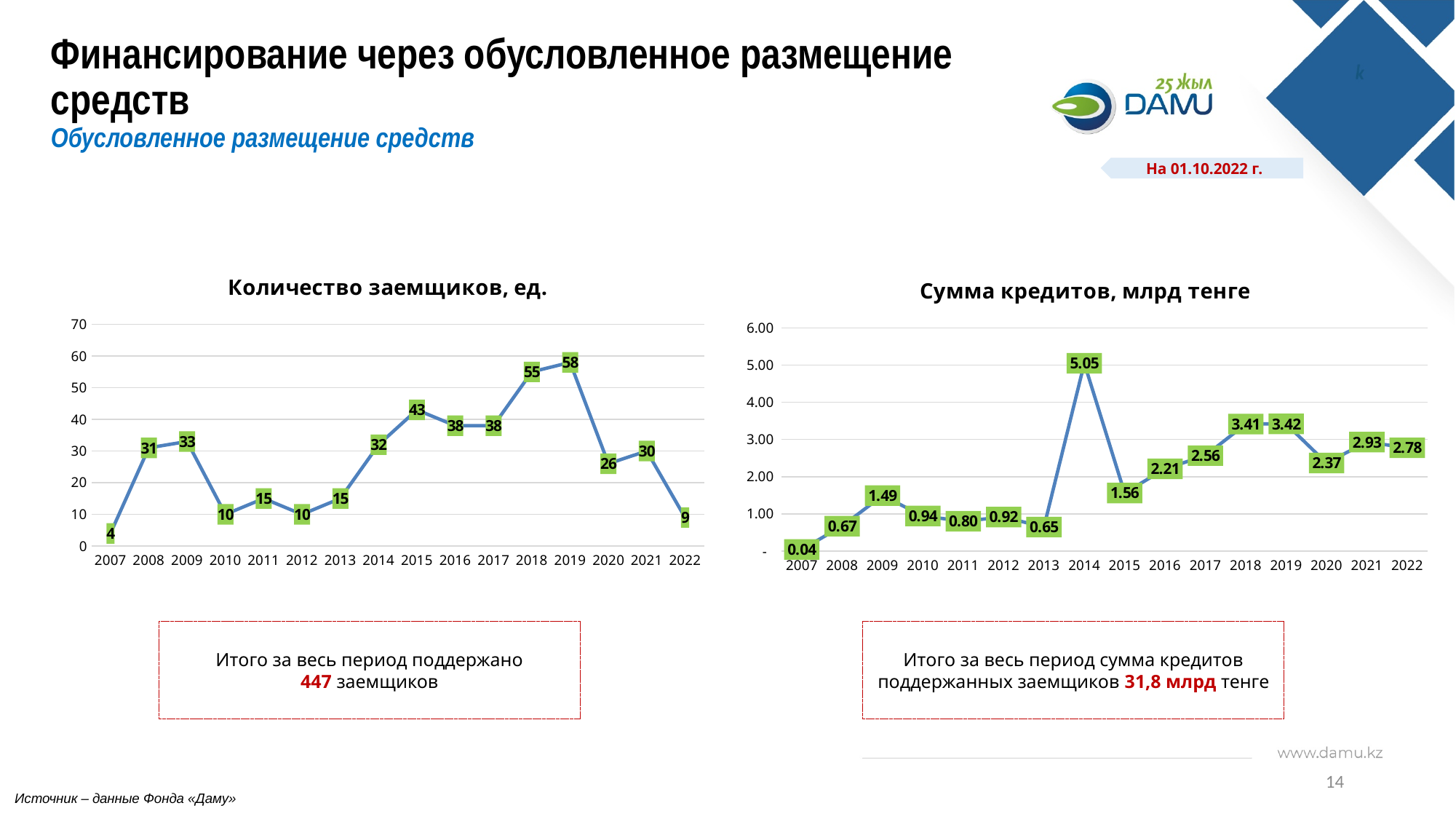
In the chart titled "Количество заемщиков, ед.", which year has the larger value, 2009 or 2014? 2009 How many years are plotted in the chart titled "Количество заемщиков, ед."? 16 In the chart titled "Сумма кредитов, млрд тенге", which year has the highest value? 2014 What type of chart is the chart titled "Сумма кредитов, млрд тенге"? Line chart In the chart titled "Сумма кредитов, млрд тенге", what is the difference between the values for 2014 and 2015? 3.49 In the chart titled "Сумма кредитов, млрд тенге", which year has the larger value, 2021 or 2022? 2021 In the chart titled "Сумма кредитов, млрд тенге", what is the value for 2007? 0.04 In the chart titled "Сумма кредитов, млрд тенге", what is the value for 2014? 5.05 In the chart titled "Количество заемщиков, ед.", which year has the lowest value? 2007 In the chart titled "Количество заемщиков, ед.", do the values rise or fall from 2019 to 2020? Fall In the chart titled "Количество заемщиков, ед.", what is the value for 2019? 58 In the chart titled "Количество заемщиков, ед.", what is the difference between the values for 2019 and 2020? 32